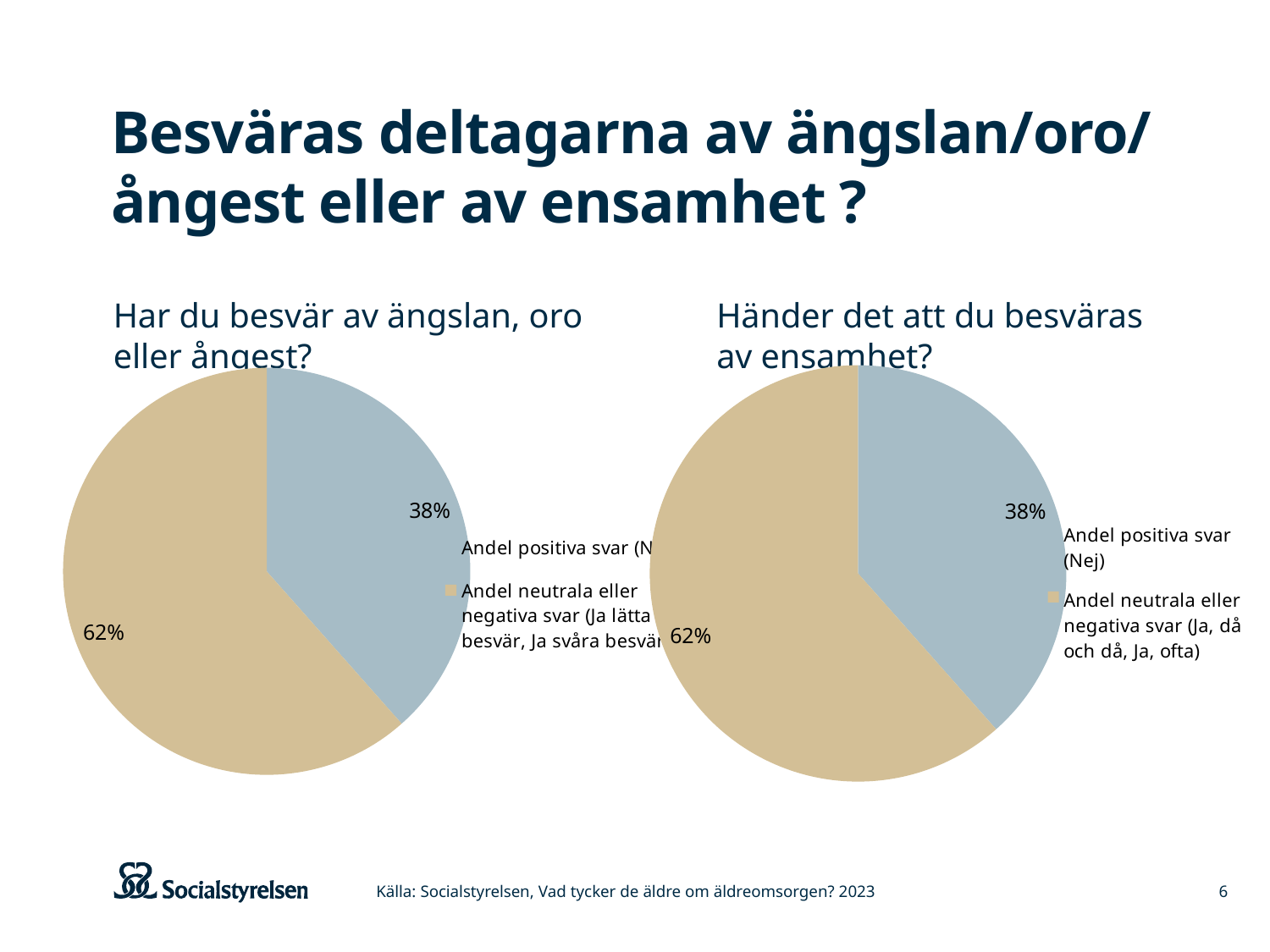
In the right pie chart 'Händer det att du besväras av ensamhet?', what share is labelled for 'Andel positiva svar (Nej)'? 38% In the left pie chart 'Har du besvär av ängslan, oro eller ångest?', what share is labelled for the 'Andel neutrala eller negativa svar' slice? 62% In the right pie chart 'Händer det att du besväras av ensamhet?', which slice is the largest? Andel neutrala eller negativa svar (Ja, då och då, Ja, ofta) In the left pie chart 'Har du besvär av ängslan, oro eller ångest?', which slice is the smallest? Andel positiva svar How many slices does the right pie chart 'Händer det att du besväras av ensamhet?' have? 2 In the right pie chart 'Händer det att du besväras av ensamhet?', what share is labelled for 'Andel neutrala eller negativa svar'? 62% What type of chart is used for 'Har du besvär av ängslan, oro eller ångest?'? pie chart How many charts are shown on the slide? 2 In the right pie chart 'Händer det att du besväras av ensamhet?', what is the difference in percentage points between the two slices? 24 percentage points In the right pie chart 'Händer det att du besväras av ensamhet?', how many entries does the legend list? 2 In the left pie chart 'Har du besvär av ängslan, oro eller ångest?', what share is labelled for the 'Andel positiva svar' slice? 38% In the left pie chart 'Har du besvär av ängslan, oro eller ångest?', is the 'Andel positiva svar' slice larger or smaller than the 'Andel neutrala eller negativa svar' slice? smaller